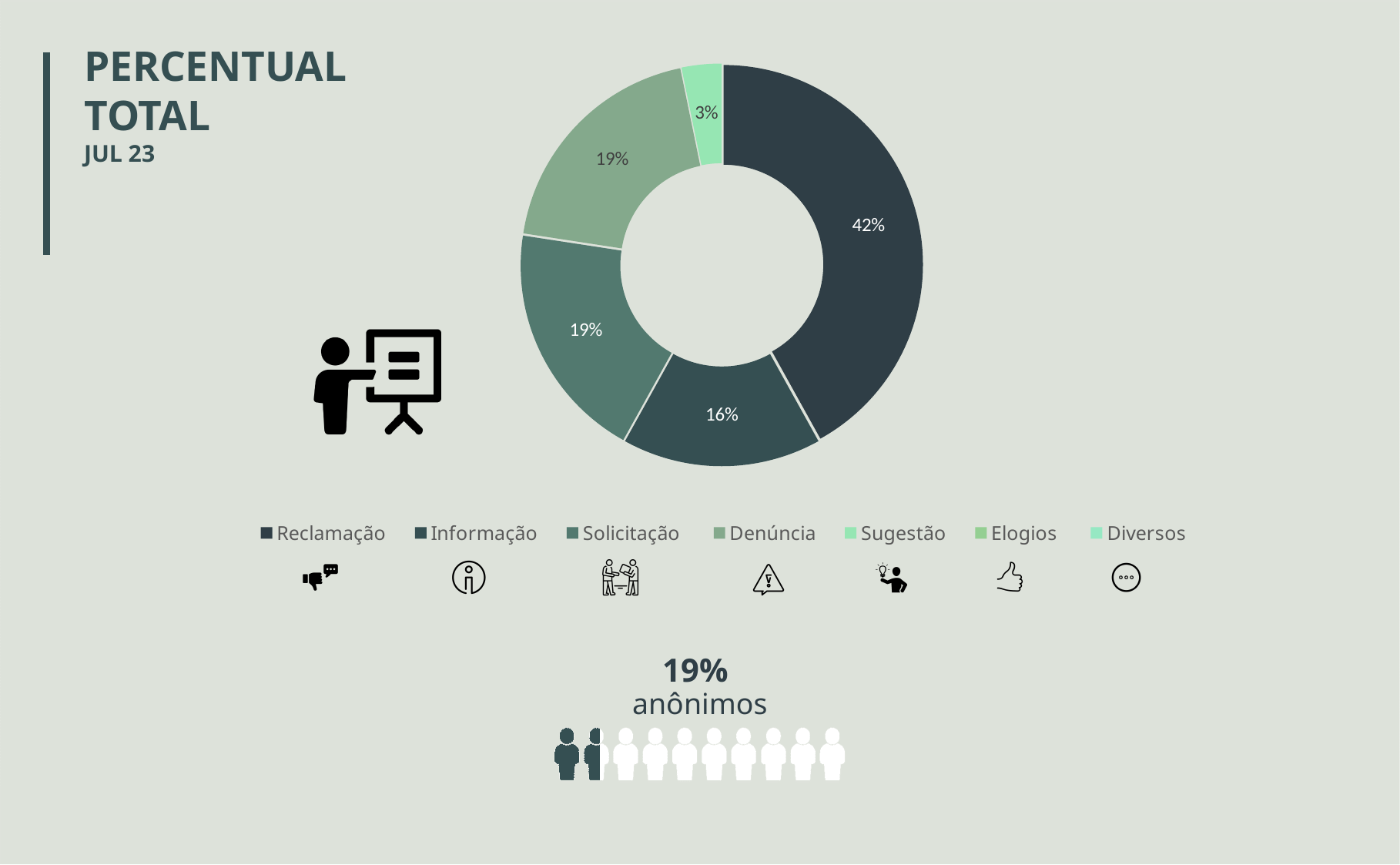
Which category has the largest slice of the pie chart? Reclamação What type of chart is shown on the slide? Pie chart (donut) Which category has the smallest labeled slice in the pie chart? Sugestão Which slice is larger, Reclamação or Solicitação? Reclamação What is the combined share of the Solicitação and Denúncia slices? 38% How many categories does the legend of the pie chart list? 7 What is the value shown for Solicitação in the pie chart? 19% What percentage of the pie chart does Reclamação represent? 42% What percentage is labeled on the Sugestão slice? 3% What percentage does the Informação slice show? 16% How many percentage points larger is the Reclamação slice than the Informação slice? 26 percentage points What is the title of the chart on the slide? PERCENTUAL TOTAL